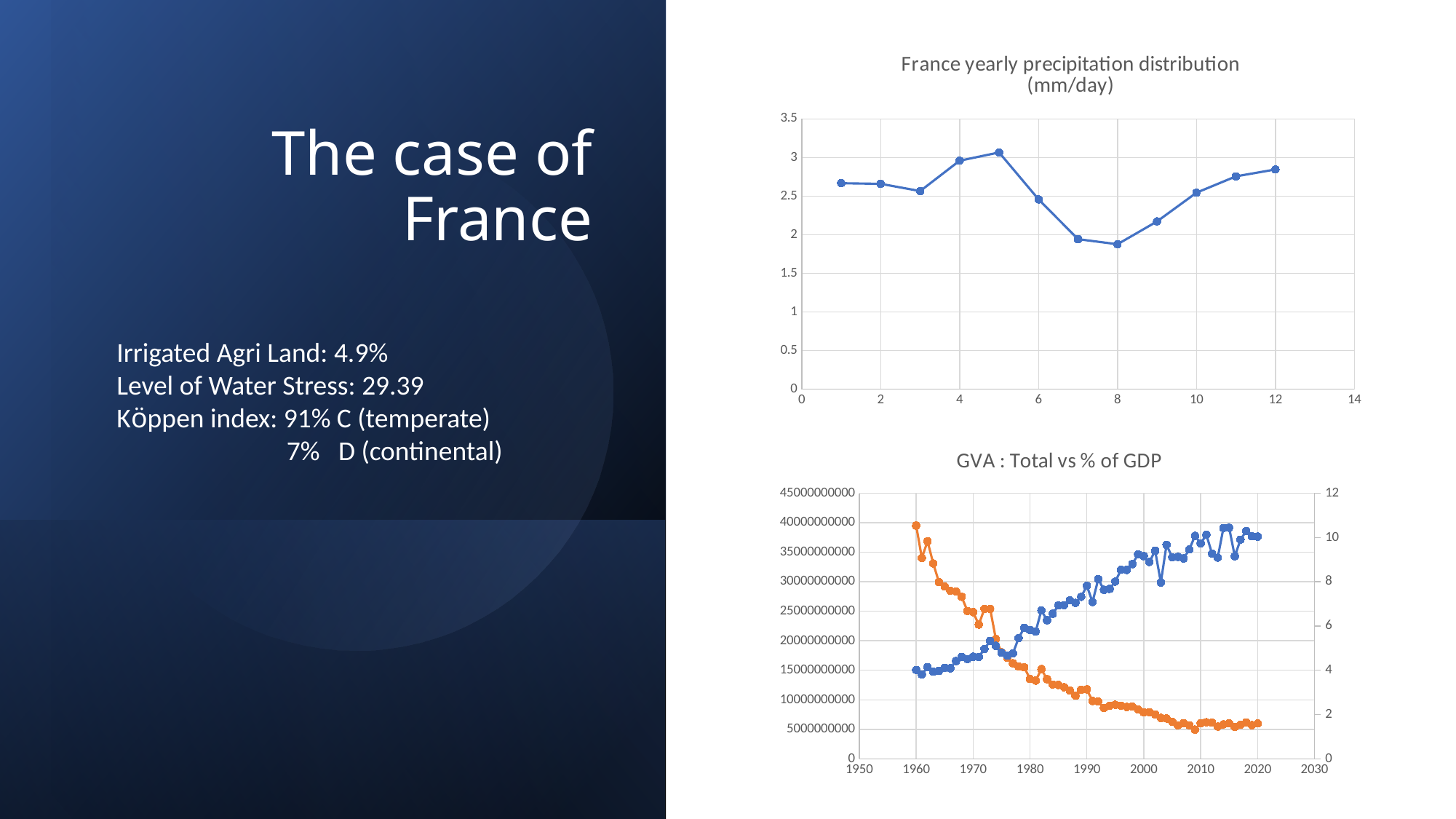
In the 'France yearly precipitation distribution (mm/day)' chart, do the values rise or fall between x = 5 and x = 8? fall In the 'France yearly precipitation distribution (mm/day)' chart, is the value at x = 12 greater or less than 2.5? greater What is the title of the top chart on the slide? France yearly precipitation distribution (mm/day) In the 'France yearly precipitation distribution (mm/day)' chart, how many data points are plotted? 12 In the 'France yearly precipitation distribution (mm/day)' chart, is the value at x = 8 greater or less than 2? less In the 'France yearly precipitation distribution (mm/day)' chart, is the value at x = 5 greater or less than 3? greater What kind of chart is the top chart, 'France yearly precipitation distribution (mm/day)'? line chart In the 'France yearly precipitation distribution (mm/day)' chart, which has the larger value: x = 4 or x = 9? x = 4 What is the title of the bottom chart on the slide? GVA : Total vs % of GDP In the 'France yearly precipitation distribution (mm/day)' chart, do the values rise or fall between x = 8 and x = 12? rise In the 'GVA : Total vs % of GDP' chart, does the orange series rise or fall from 1960 to 2020? fall In the 'France yearly precipitation distribution (mm/day)' chart, at which x value is the precipitation highest? 5